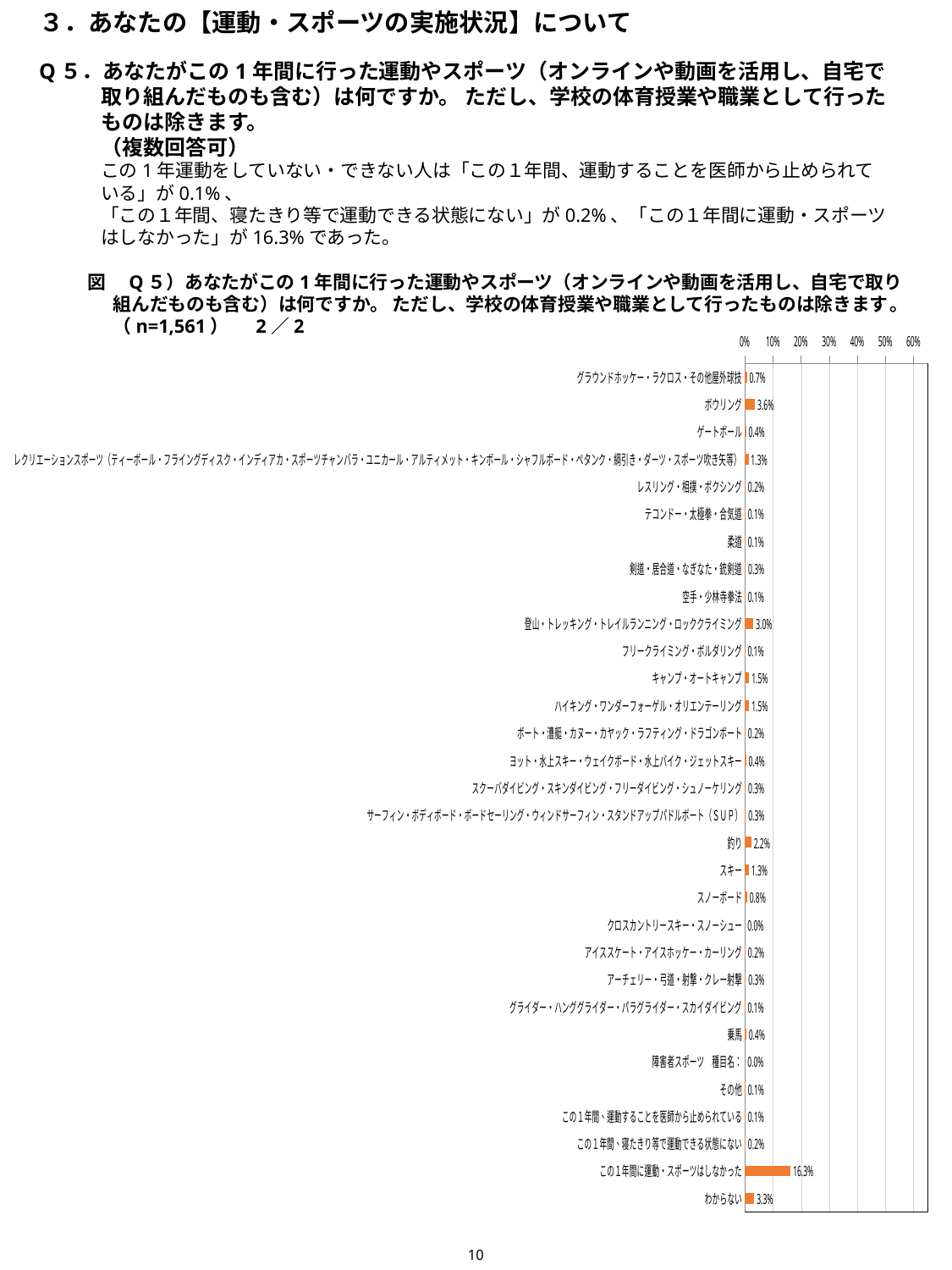
What is the value for この1年間に運動・スポーツはしなかった? 16.3% Is the value for この1年間に運動・スポーツはしなかった greater or less than 10%? greater What is the value for ボウリング? 3.6% Which has a larger value, スキー or スノーボード? スキー How many categories are plotted in the chart? 31 What is the difference between the values for ボウリング and 登山・トレッキング・トレイルランニング・ロッククライミング? 0.6% Which category has the highest value in the chart? この1年間に運動・スポーツはしなかった What is the value for わからない? 3.3% What is the sample size (n) stated in the chart title? 1,561 How many categories show a value of 0.0%? 2 What type of chart is shown on the slide? bar chart What is the value for 釣り? 2.2%